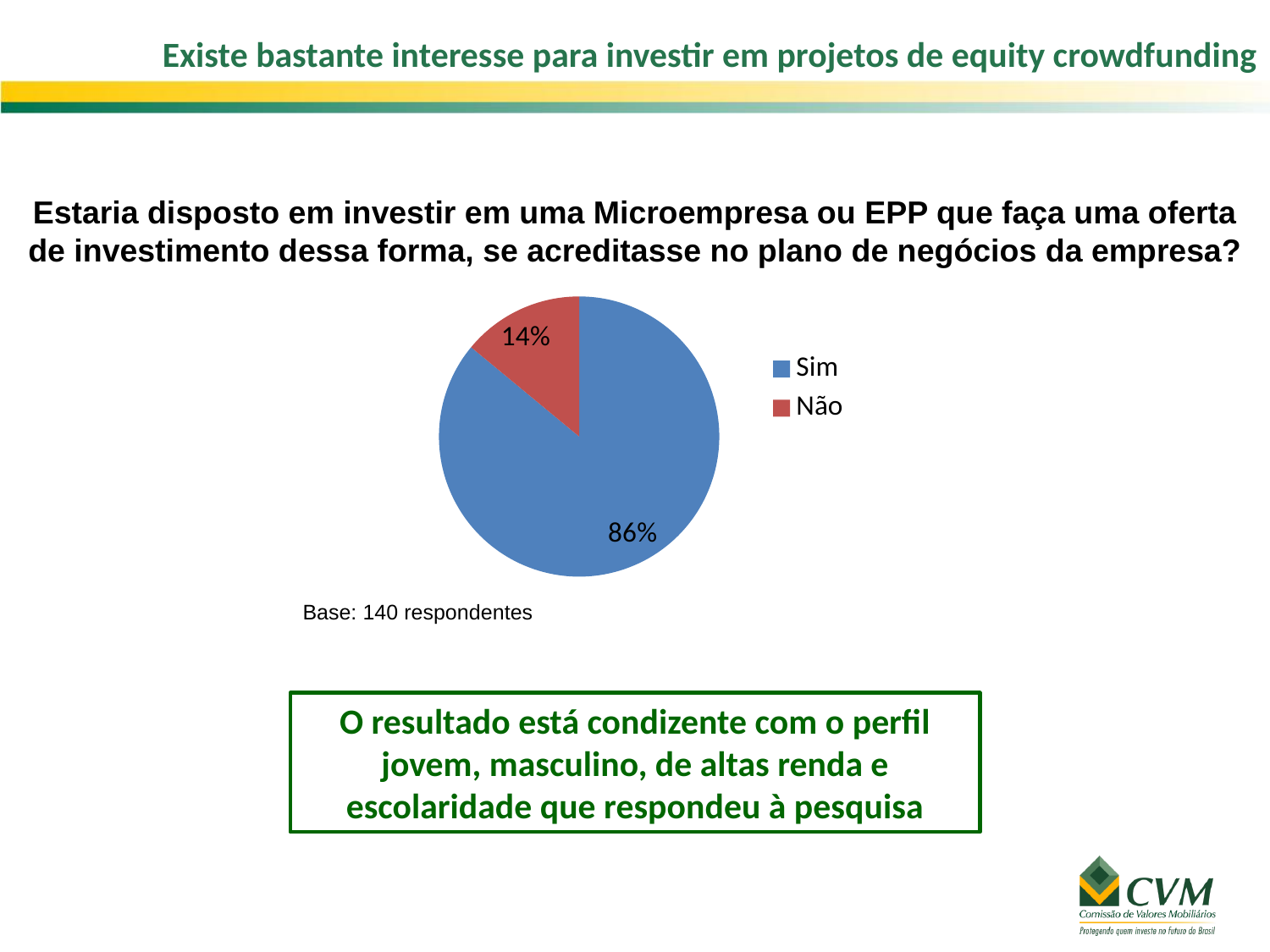
How many slices does the pie chart have? 2 How many entries does the legend list? 2 Which slice is larger, "Sim" or "Não"? Sim What kind of chart is shown on the slide? pie chart Which response has the smallest slice of the pie? Não Which response has the largest slice of the pie? Sim What share of respondents answered "Sim"? 86% What is the difference in percentage points between the "Sim" and "Não" slices? 72 What share of respondents answered "Não"? 14% What colour is the "Não" slice? red How many respondents form the base of the chart? 140